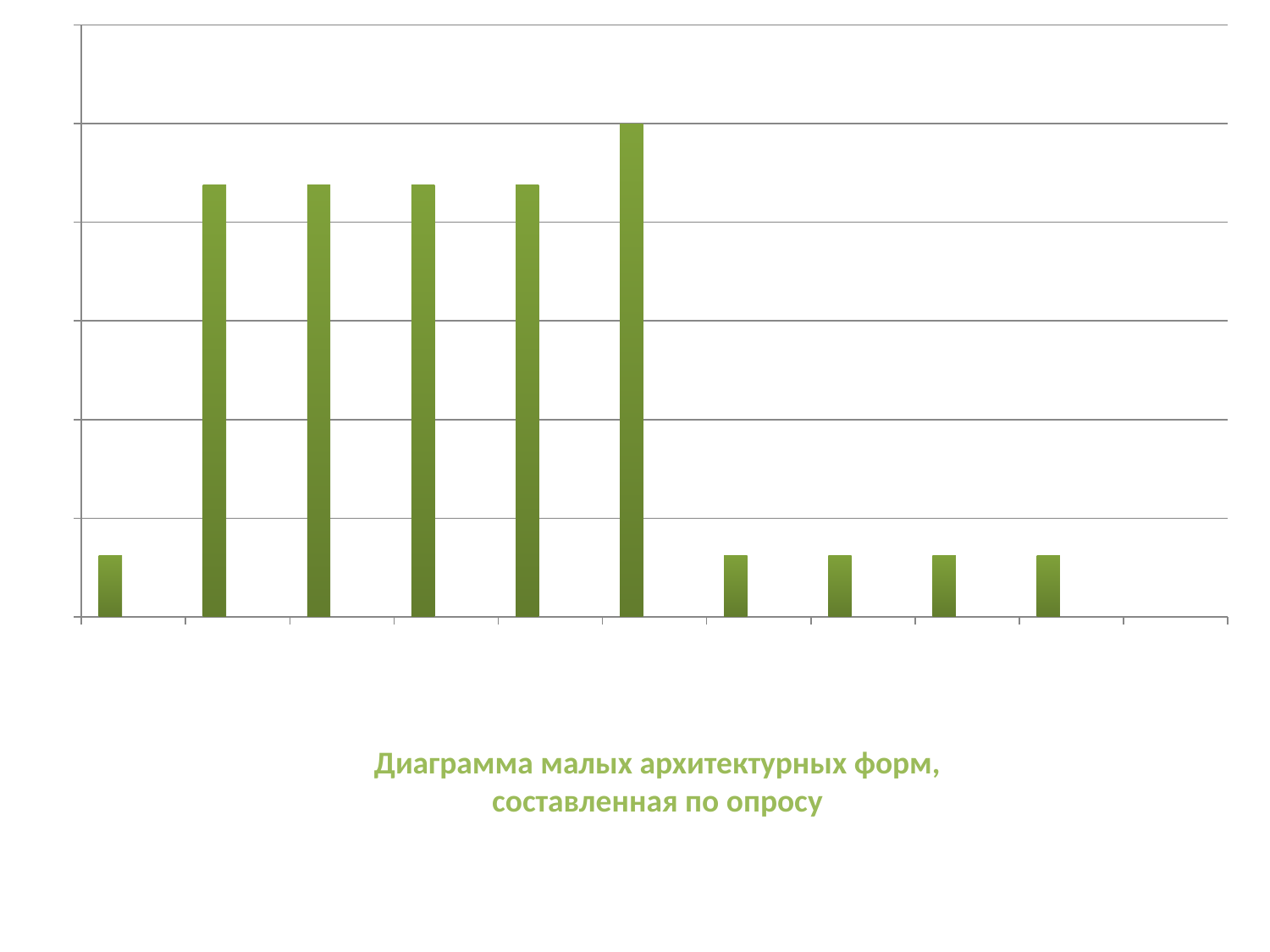
What colour are the bars in the chart? green How many bars are plotted in the chart? 10 Is the first bar from the left taller or shorter than the second bar from the left? shorter Counting from the left, which bar is the tallest in the chart? the sixth Is the sixth bar from the left taller or shorter than the seventh bar from the left? taller What is the title of the chart on the slide? Диаграмма малых архитектурных форм, составленная по опросу What kind of chart is shown on the slide? bar chart